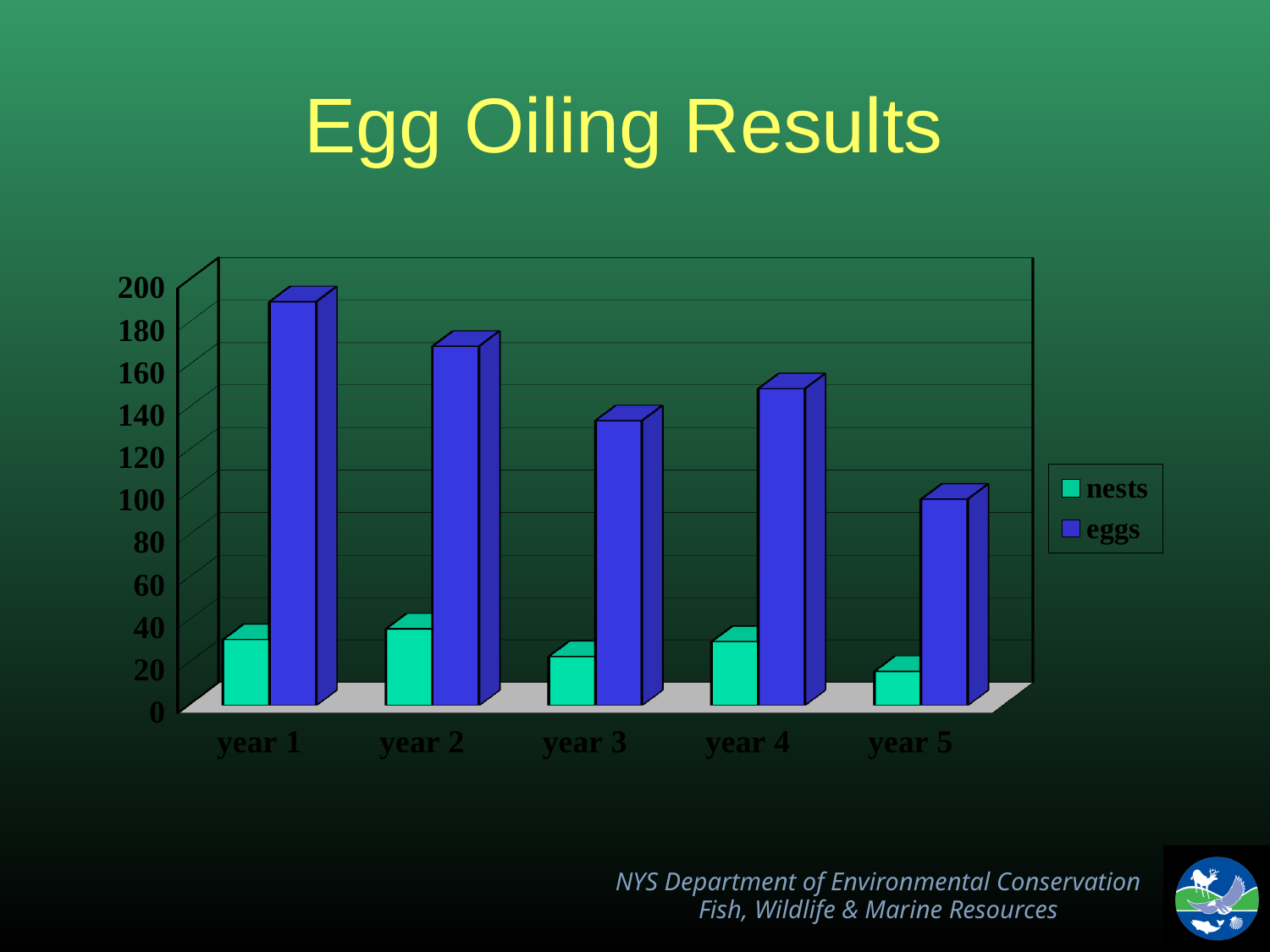
Is the value for eggs in year 1 greater or less than 180? greater Which is larger, the eggs value for year 3 or for year 4? year 4 What is the title of the chart? Egg Oiling Results Is the value for eggs in year 5 greater or less than 120? less Which year has the lowest value for eggs? year 5 Which year has the highest value for eggs? year 1 What kind of chart is shown on the slide? bar chart What are the two series named in the legend? nests and eggs How many years are shown on the x axis? 5 Which year has the lowest value for nests? year 5 How many series does the legend list? 2 Is the value for nests in year 2 greater or less than 60? less